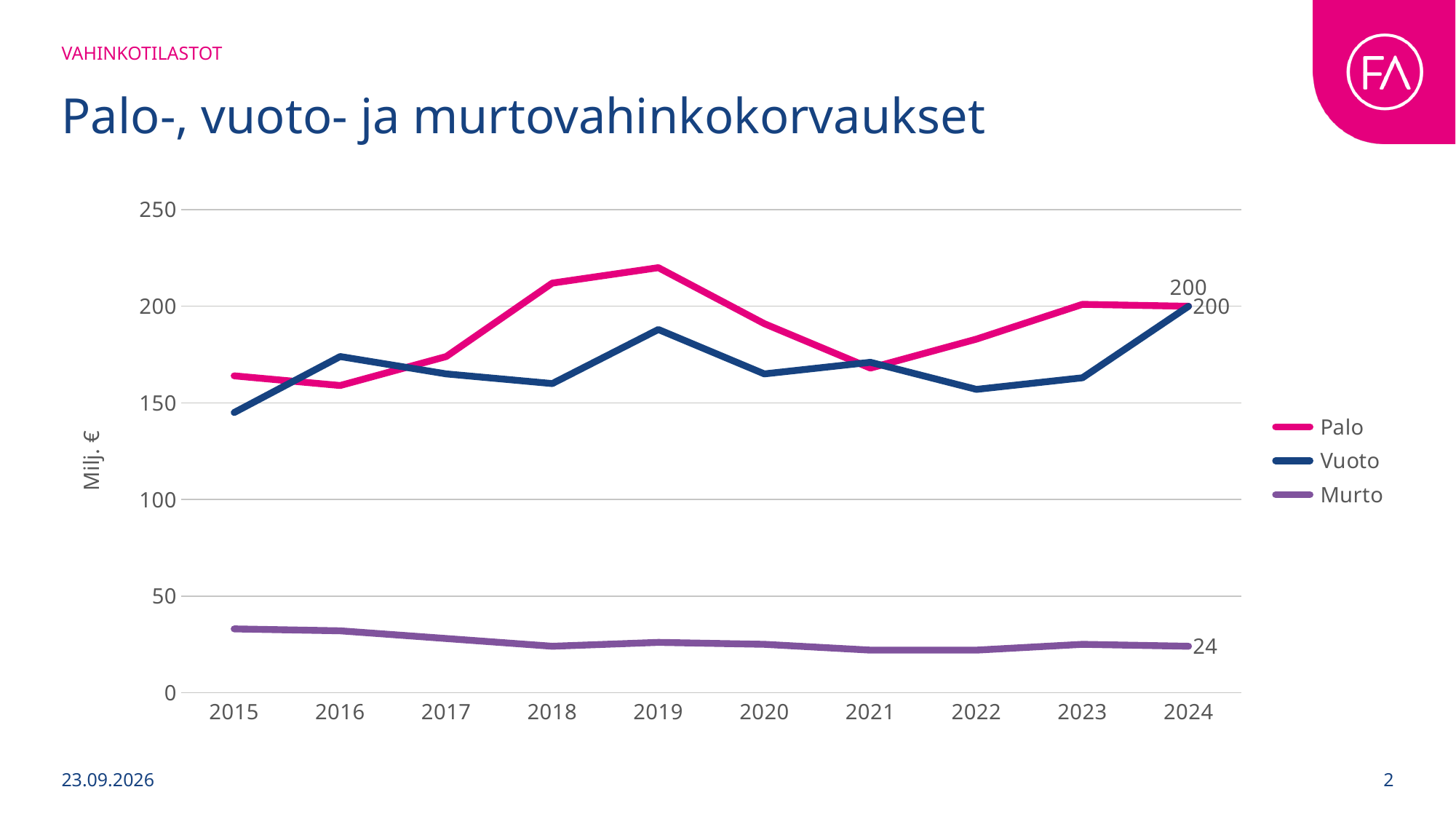
Is the value for Palo in 2019 greater or less than 200? greater What is the value for Palo in 2024? 200 What is the value for Murto in 2024? 24 Is the value for Vuoto in 2015 greater or less than 150? less Does the Murto line rise or fall overall from 2015 to 2024? fall What is the value for Vuoto in 2024? 200 What is the difference between Palo and Murto in 2024? 176 How many years are shown on the x axis? 10 In 2018, which is larger, Palo or Vuoto? Palo How many series does the legend list? 3 Which series has the lowest values across all years? Murto What kind of chart is shown on the slide? line chart